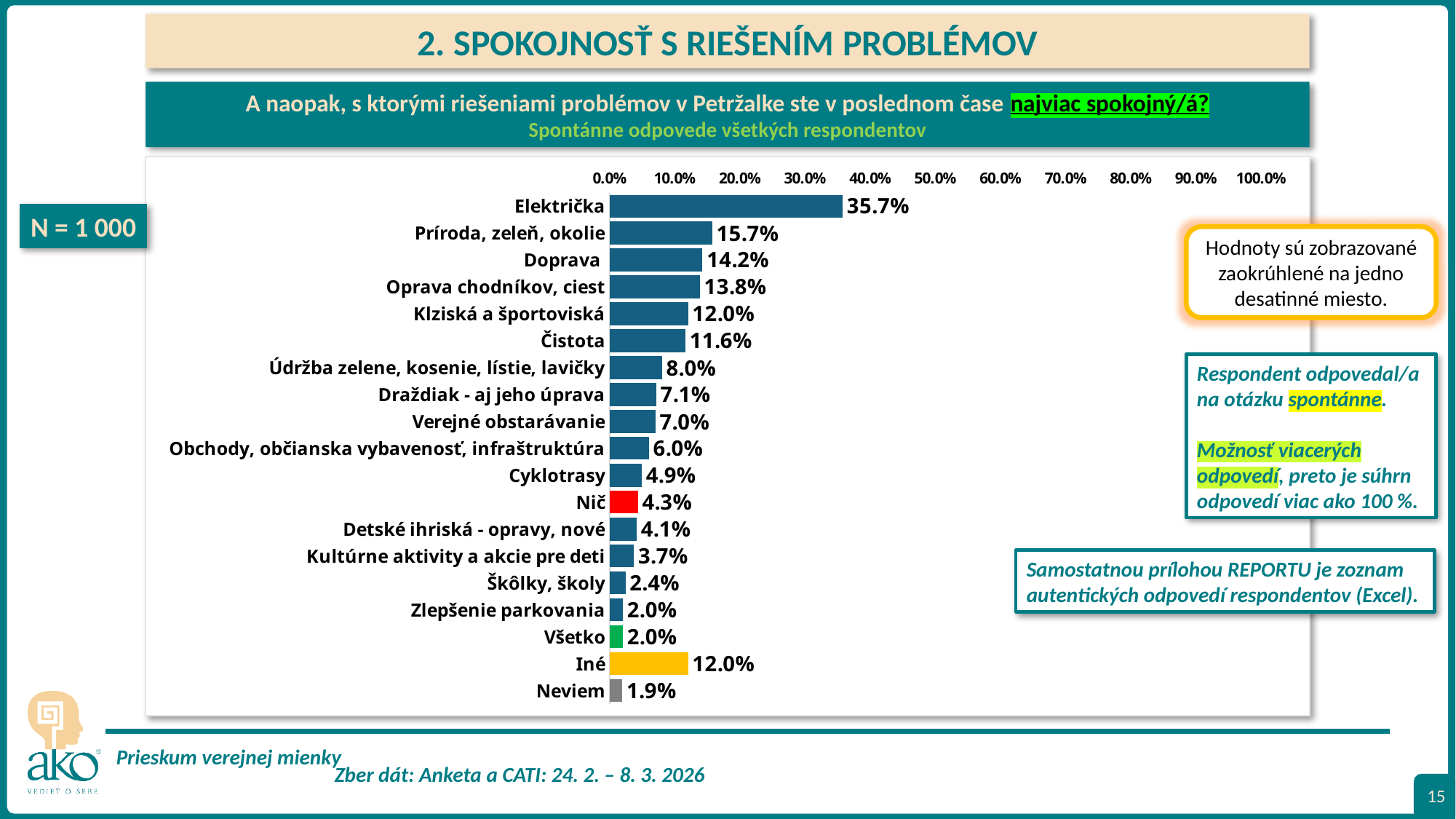
Is the value for Električka greater or less than 30.0%? greater What is the difference between the values for Električka and Príroda, zeleň, okolie? 20.0% What colour is the bar for Iné? yellow Which is larger, the value for Čistota or the value for Klziská a športoviská? Klziská a športoviská What is the value for Iné? 12.0% What kind of chart is shown on the slide? bar chart What is the value for Nič? 4.3% Which category has the highest value? Električka How many categories are shown in the chart? 19 What is the value for Doprava? 14.2% What is the value for Električka? 35.7% Which category has the lowest value? Neviem